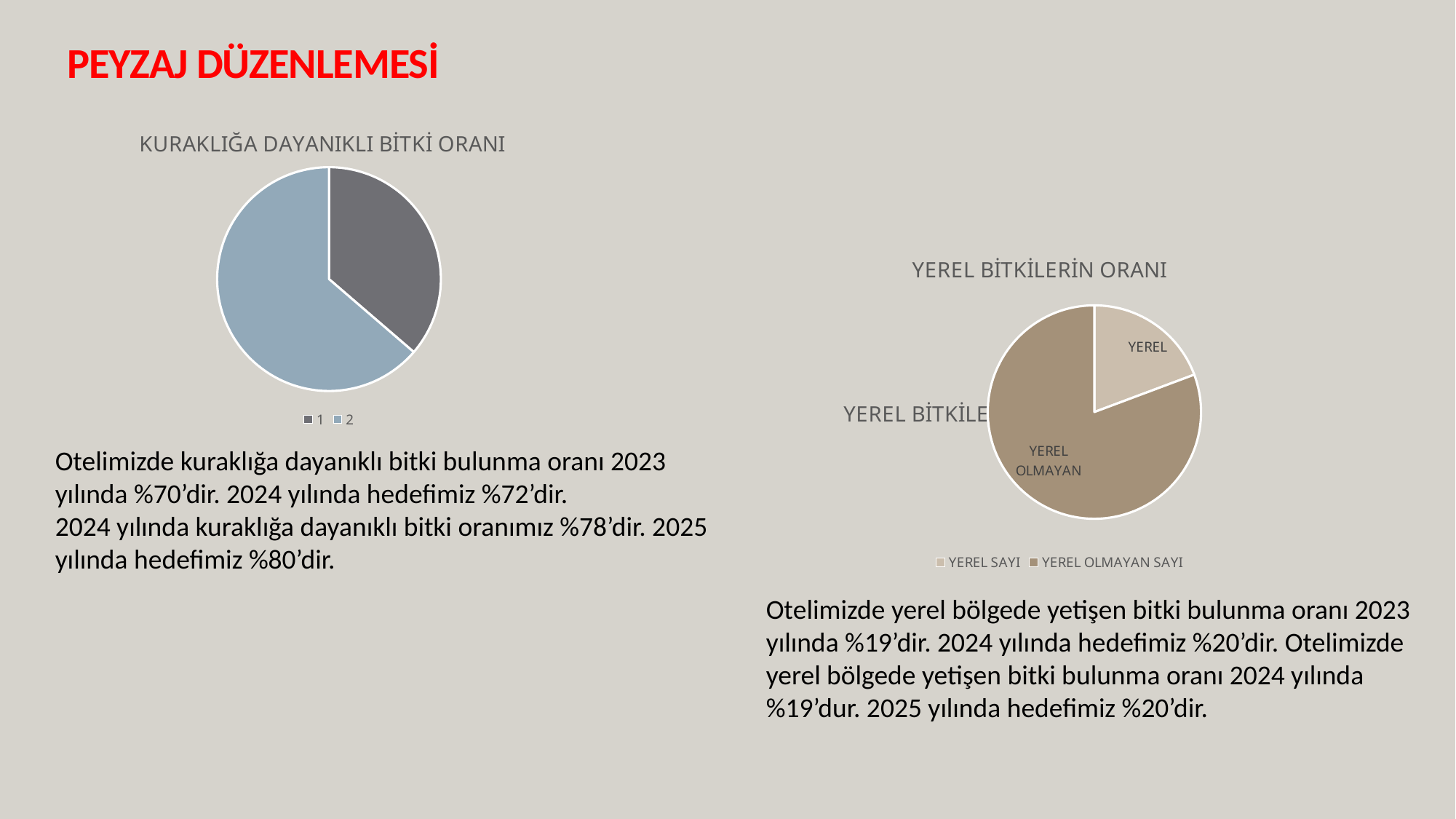
What kind of chart is the chart titled "KURAKLIĞA DAYANIKLI BİTKİ ORANI"? Pie chart In the chart titled "YEREL BİTKİLERİN ORANI", which slice is larger, YEREL or YEREL OLMAYAN? YEREL OLMAYAN In the chart titled "KURAKLIĞA DAYANIKLI BİTKİ ORANI", which slice is the smallest? 1 In the chart titled "YEREL BİTKİLERİN ORANI", how many entries does the legend list? 2 What kind of chart is the chart titled "YEREL BİTKİLERİN ORANI"? Pie chart What are the legend entries of the chart titled "YEREL BİTKİLERİN ORANI"? YEREL SAYI, YEREL OLMAYAN SAYI In the chart titled "KURAKLIĞA DAYANIKLI BİTKİ ORANI", which slice is larger, 1 or 2? 2 In the chart titled "KURAKLIĞA DAYANIKLI BİTKİ ORANI", how many entries does the legend list? 2 In the chart titled "YEREL BİTKİLERİN ORANI", which slice is the smallest? YEREL What is the title of the pie chart on the left side of the slide? KURAKLIĞA DAYANIKLI BİTKİ ORANI In the chart titled "KURAKLIĞA DAYANIKLI BİTKİ ORANI", how many slices does the pie have? 2 In the chart titled "YEREL BİTKİLERİN ORANI", how many slices does the pie have? 2